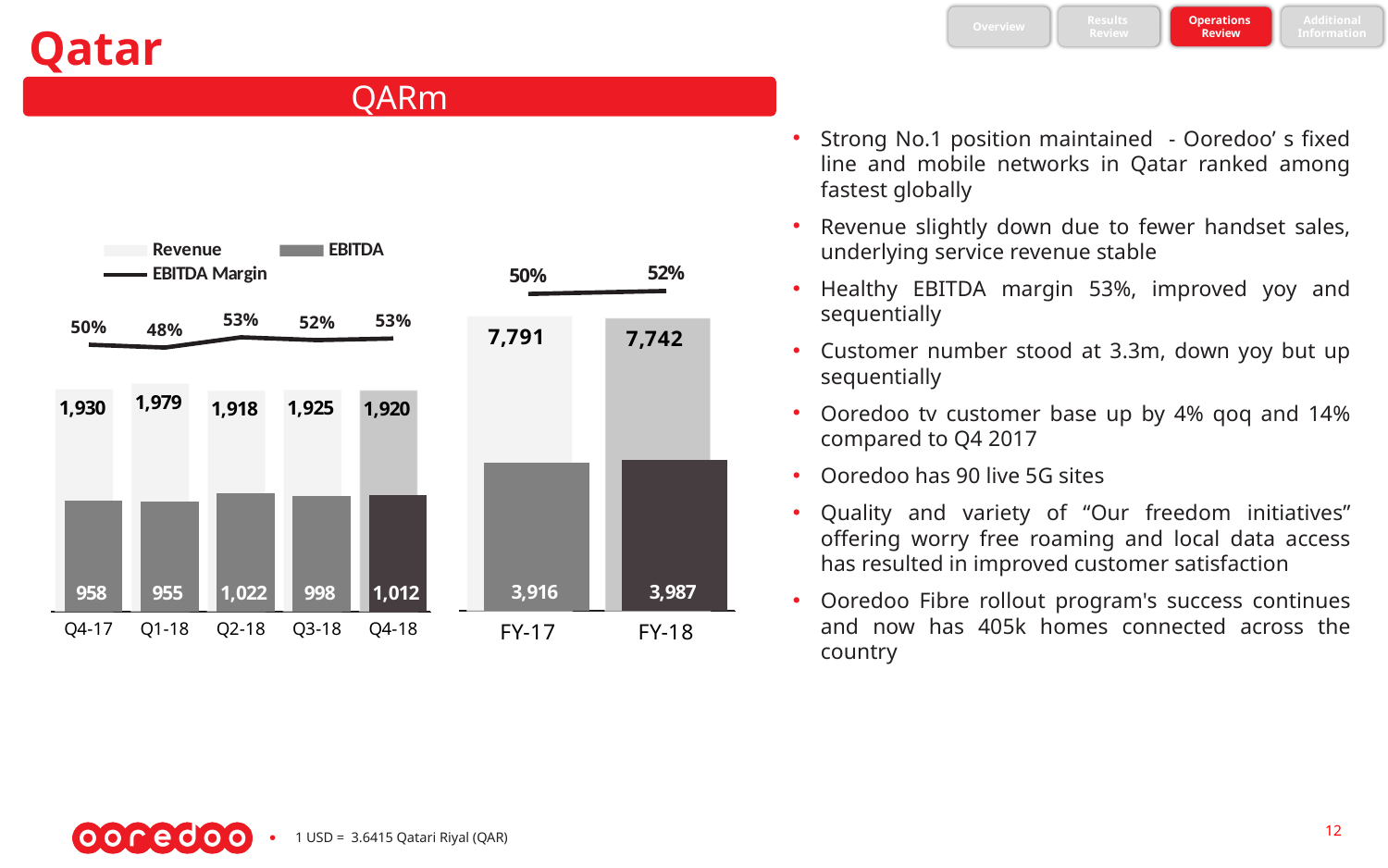
In the full-year chart on the right, which year has the higher EBITDA, FY-17 or FY-18? FY-18 In the full-year chart on the right, what is the difference in Revenue between FY-17 and FY-18? 49 In the quarterly chart on the left, how many quarters are shown on the x axis? 5 How many series does the legend of the quarterly chart list? 3 In the full-year chart on the right, what is the Revenue for FY-18? 7,742 In the quarterly chart on the left, which quarter has the highest Revenue? Q1-18 In the full-year chart on the right, what is the EBITDA for FY-17? 3,916 In the quarterly chart on the left, what is the EBITDA Margin for Q1-18? 48% In the quarterly chart on the left, what is the EBITDA for Q2-18? 1,022 In the quarterly chart on the left, which quarter has the lowest EBITDA? Q1-18 In the quarterly chart on the left, what is the Revenue for Q1-18? 1,979 In the quarterly chart on the left, what is the difference in EBITDA between Q4-18 and Q4-17? 54